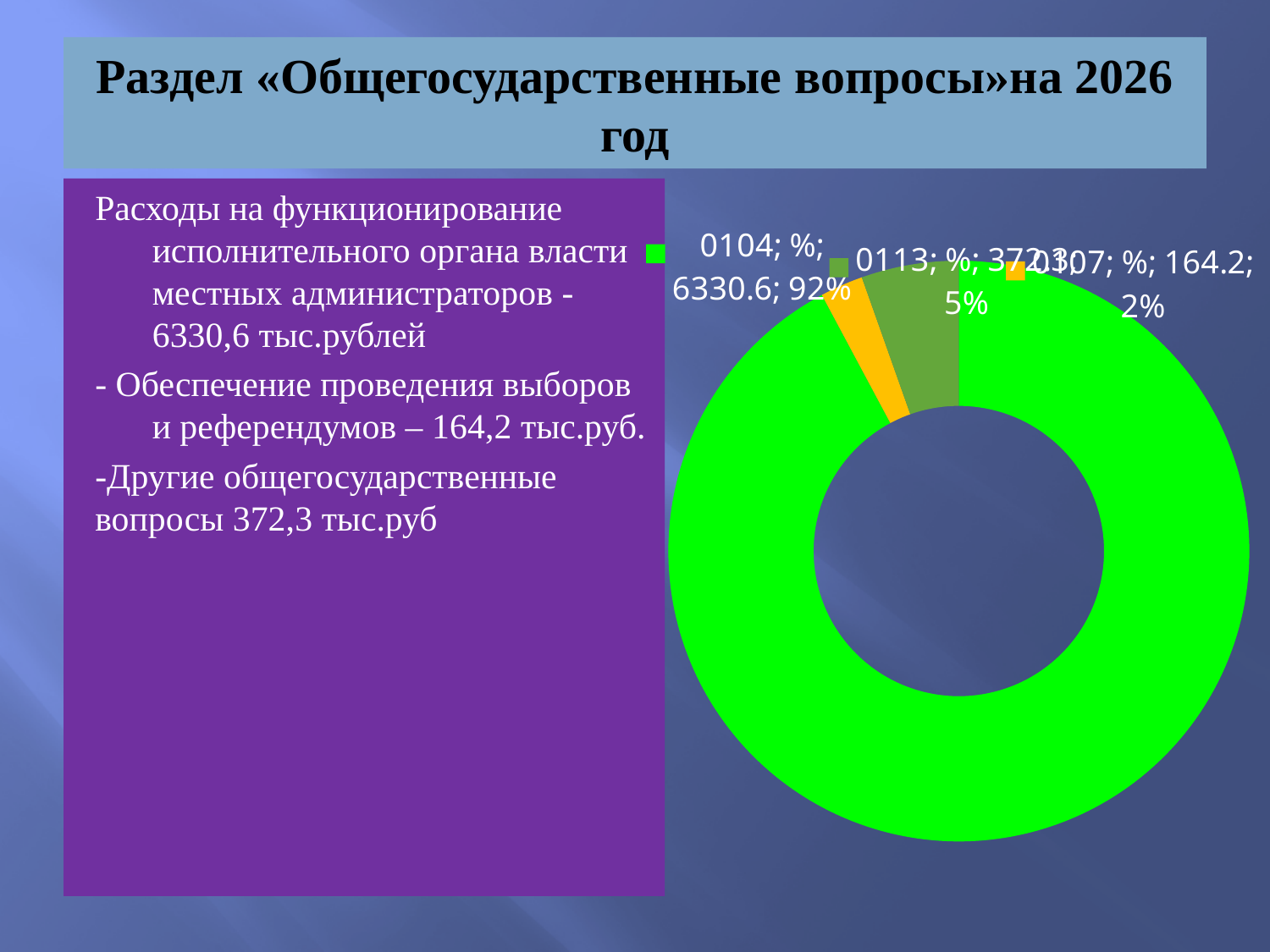
Which is larger in the doughnut chart, the value for 0113 or the value for 0107? 0113 What value is shown for category 0113 in the doughnut chart? 372.3 What percentage share does category 0104 have in the doughnut chart? 92% What value is shown for category 0104 in the doughnut chart? 6330.6 Which category has the largest slice in the doughnut chart? 0104 What colour is the slice for category 0104 in the doughnut chart? bright green Which category has the smallest slice in the doughnut chart? 0107 How many slices does the doughnut chart have? 3 What kind of chart is shown on the slide? doughnut chart What value is shown for category 0107 in the doughnut chart? 164.2 What percentage share does category 0113 have in the doughnut chart? 5% What percentage share does category 0107 have in the doughnut chart? 2%